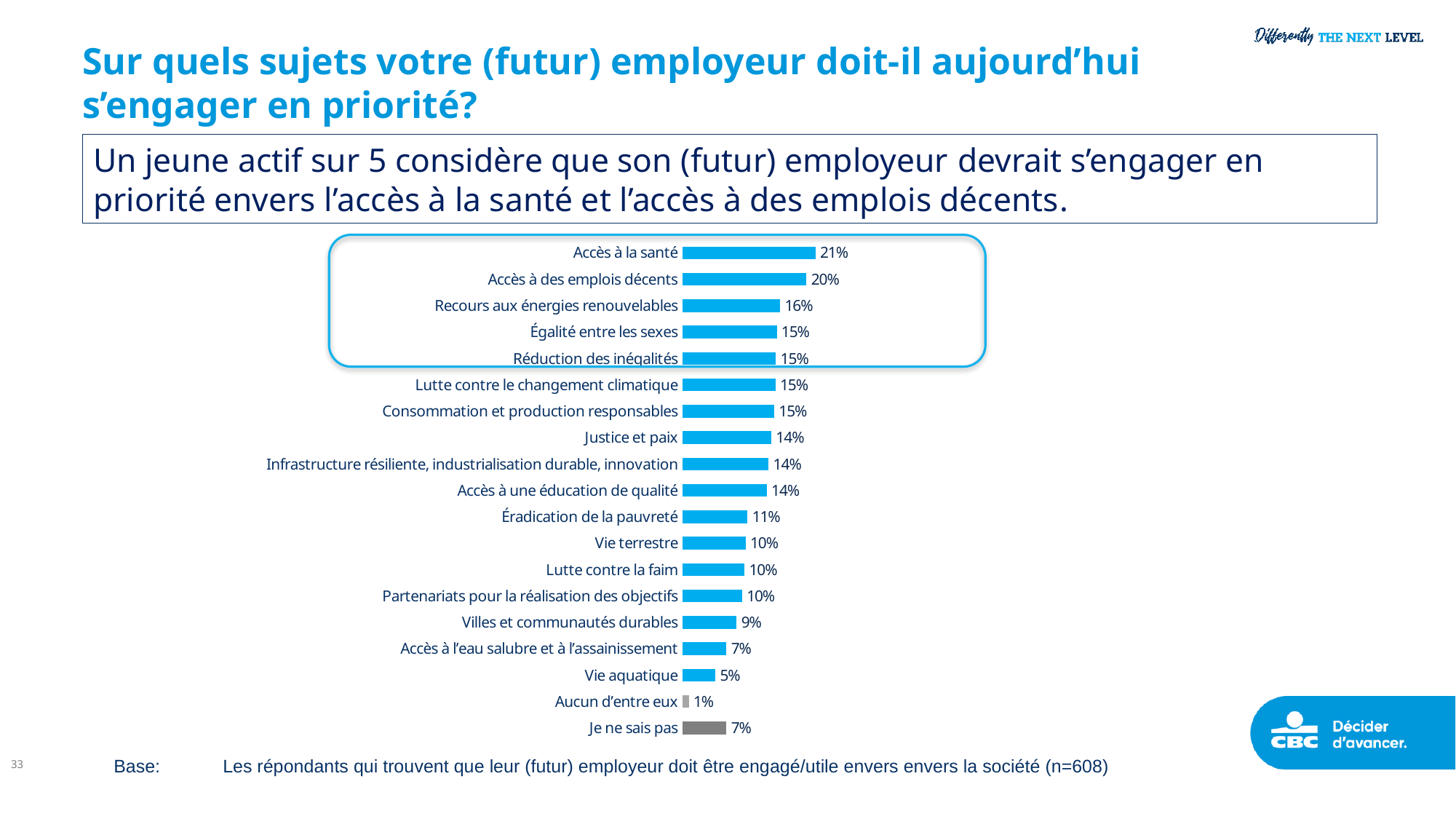
What is the value for "Accès à la santé"? 21% What is the value for "Recours aux énergies renouvelables"? 16% What is the difference between the values for "Accès à la santé" and "Accès à des emplois décents"? 1% What is the difference between the values for "Éradication de la pauvreté" and "Vie aquatique"? 6% What is the value for "Je ne sais pas"? 7% What kind of chart is shown on the slide? Bar chart Which is larger, the value for "Justice et paix" or the value for "Villes et communautés durables"? Justice et paix Which category has the highest value? Accès à la santé Which category has the lowest value? Aucun d'entre eux How many categories are shown in the chart? 19 What is the value for "Vie aquatique"? 5% How many categories are enclosed in the highlighted box at the top of the chart? 5